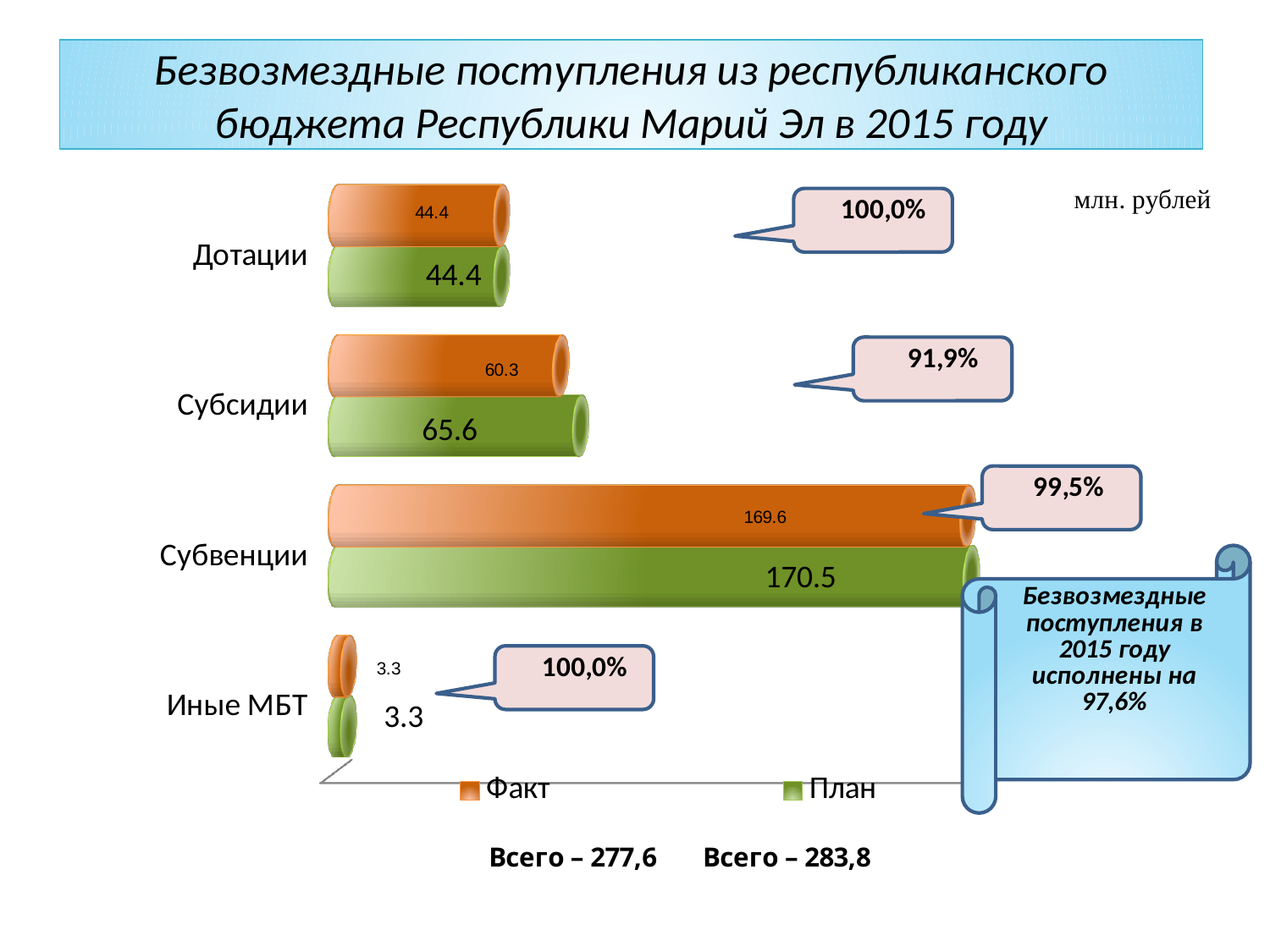
How many categories are shown in the chart? 4 What is the Факт value for Субсидии? 60.3 What is the План value for Субвенции? 170.5 What is the difference between the План and Факт values for Субсидии? 5.3 Which is larger for Субсидии, the Факт value or the План value? План What is the difference between the План and Факт values for Субвенции? 0.9 What is the План value for Дотации? 44.4 Which category has the lowest План value? Иные МБТ What is the Факт value for Иные МБТ? 3.3 What type of chart is shown on the slide? Bar chart Which category has the highest Факт value? Субвенции How many series does the legend list? 2